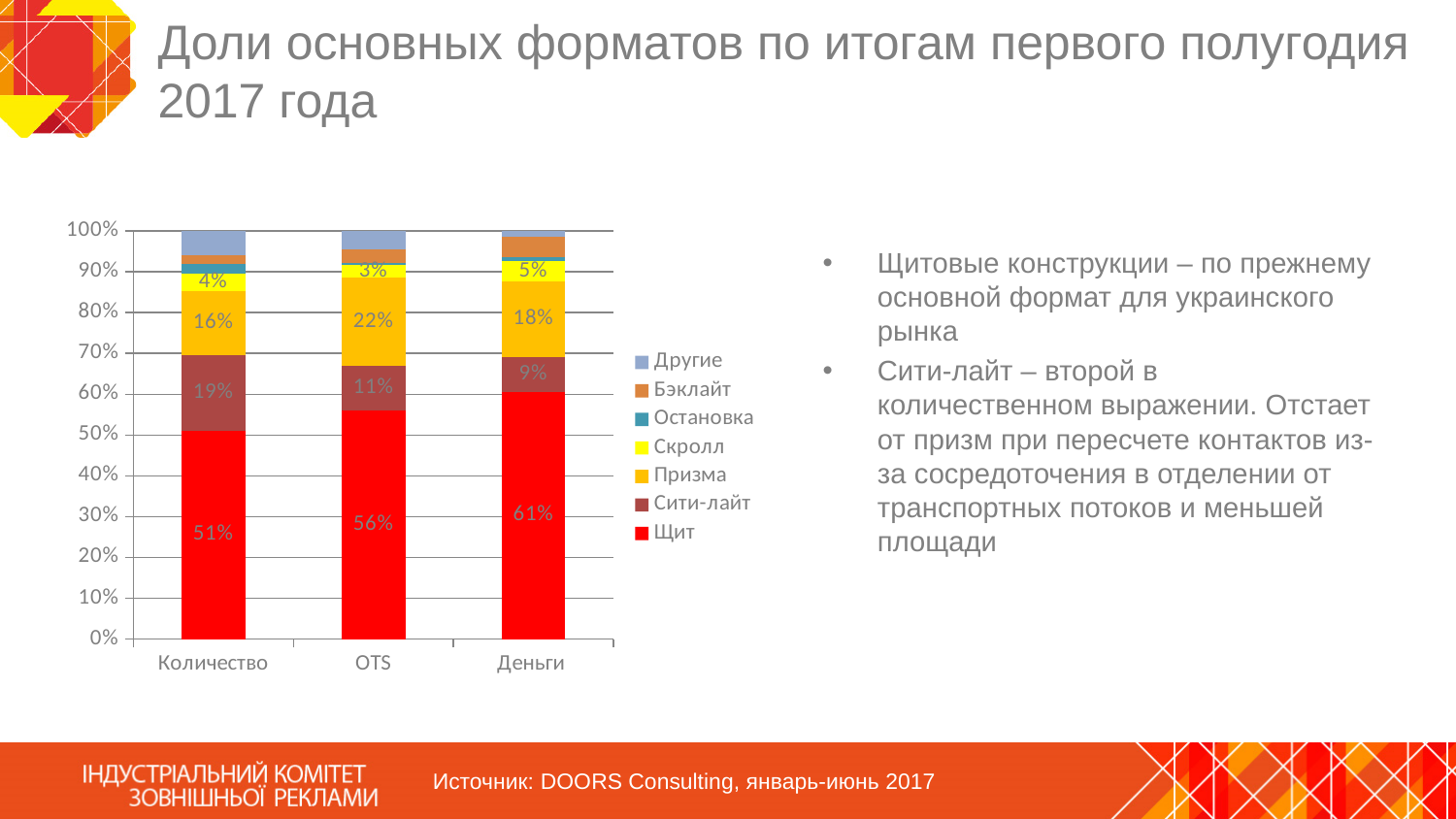
What is the value of Сити-лайт for Деньги? 9% In which category is the Щит share highest? Деньги How many categories are shown on the x axis of the chart? 3 Does the Щит share rise or fall from Количество to Деньги? Rise How many series does the chart legend list? 7 What is the value of Призма for OTS? 22% What type of chart is shown on the slide? Stacked bar chart What is the value of Щит for Количество? 51% In which category is the Сити-лайт share lowest? Деньги What is the difference between the Щит share for Деньги and for Количество? 10% Which is larger: the Призма share for OTS or for Количество? OTS What is the value of Скролл for Деньги? 5%